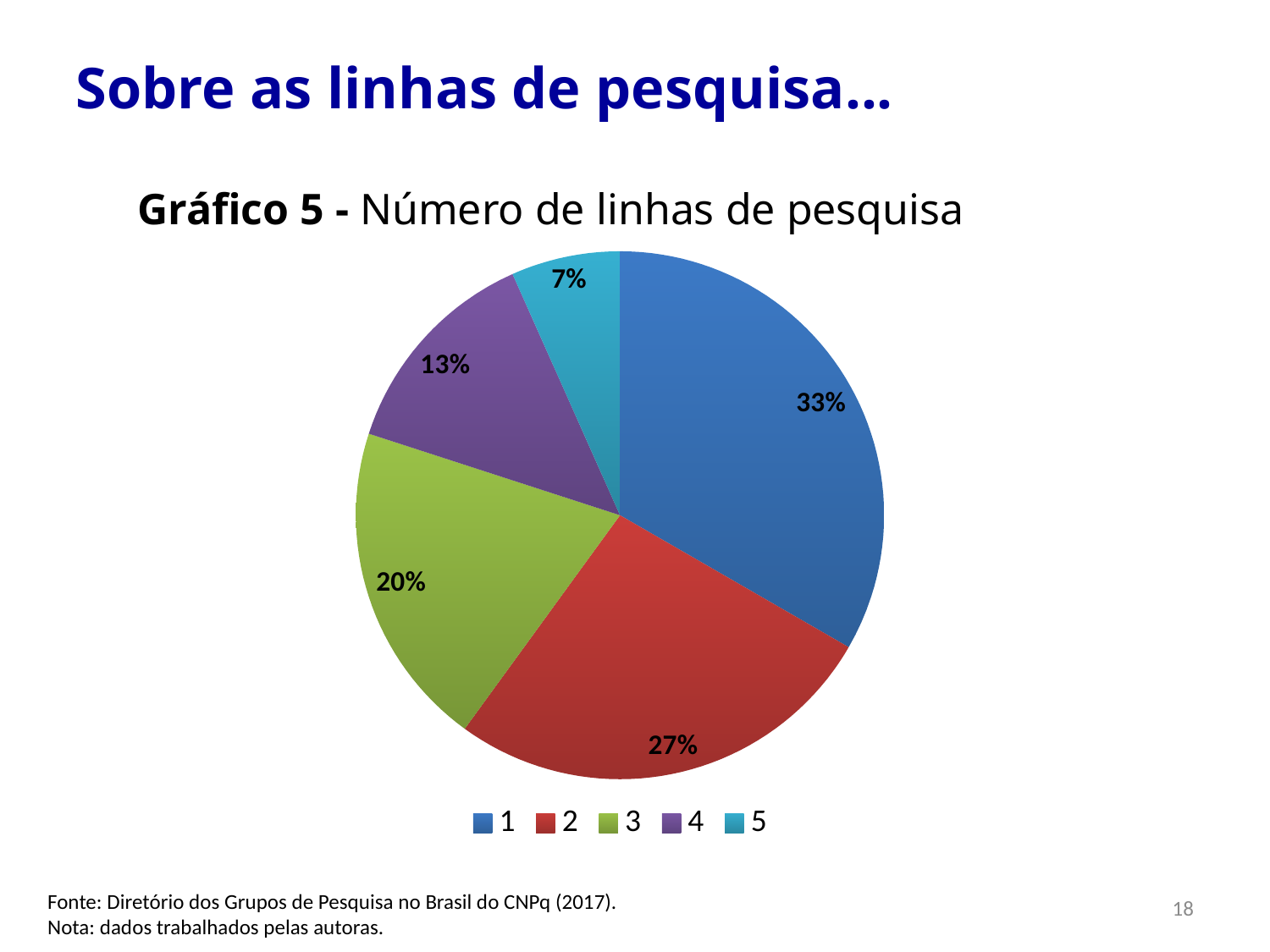
What is the title of the chart? Gráfico 5 - Número de linhas de pesquisa What share of the pie does category 3 have? 20% What share of the pie does category 5 have? 7% What is the difference in percentage points between the slices for category 1 and category 3? 13 What kind of chart is shown on the slide? pie chart How many categories does the legend list? 5 What share of the pie does category 4 have? 13% Which category has the largest slice of the pie? 1 Which slice is larger, category 2 or category 4? 2 Which category has the smallest slice of the pie? 5